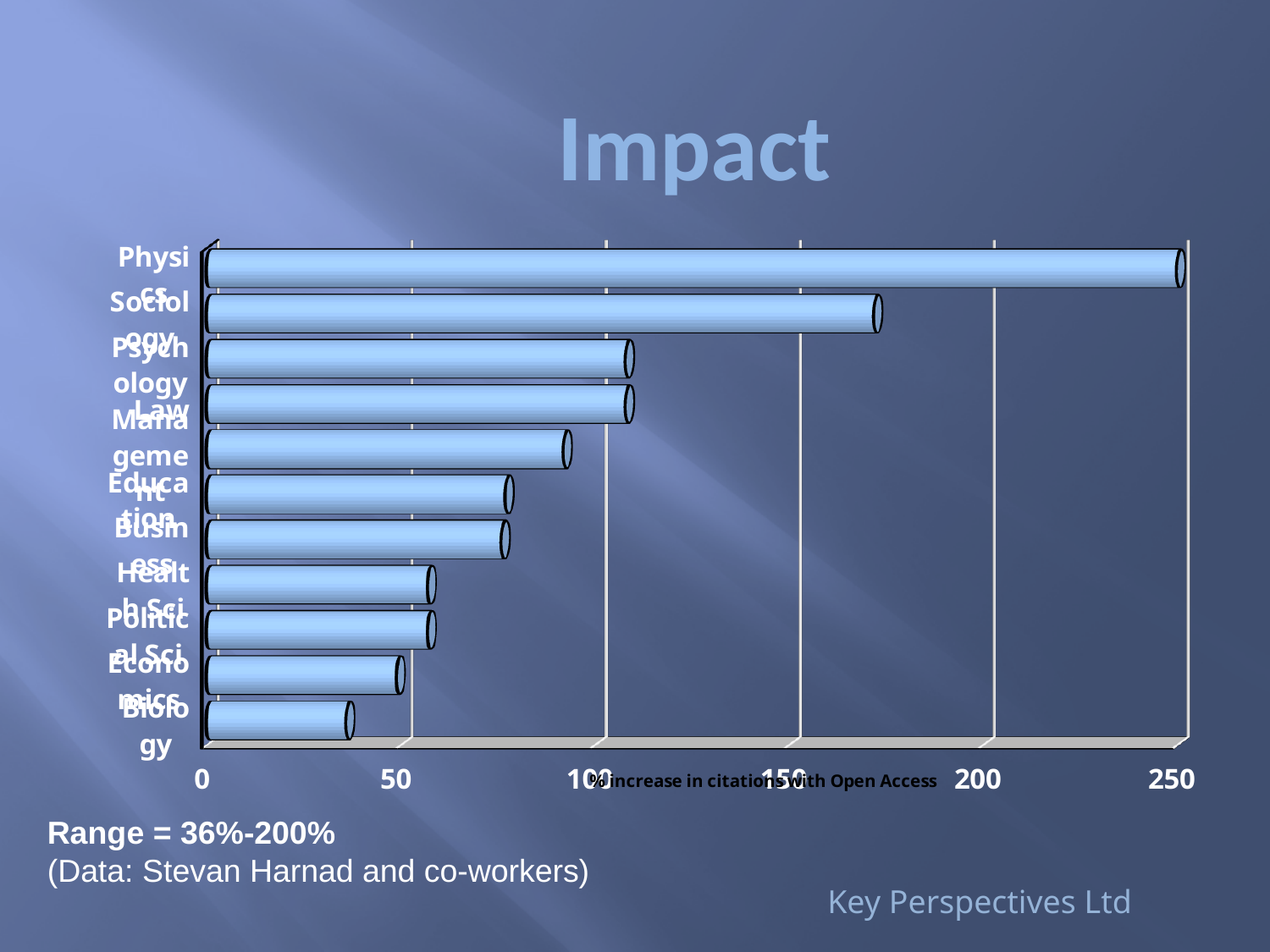
Which discipline has the highest % increase in citations with Open Access? Physics Is the value for Management greater or less than 100? less Is the value for Sociology greater or less than 150? greater Is the value for Biology greater or less than 50? less Which has a larger value, Economics or Management? Management What kind of chart is shown on the slide? bar chart Which has a larger value, Sociology or Psychology? Sociology Which discipline has the lowest % increase in citations with Open Access? Biology How many categories (disciplines) are plotted in the chart? 11 What is the label on the horizontal axis of the chart? % increase in citations with Open Access What is the title of the chart? Impact